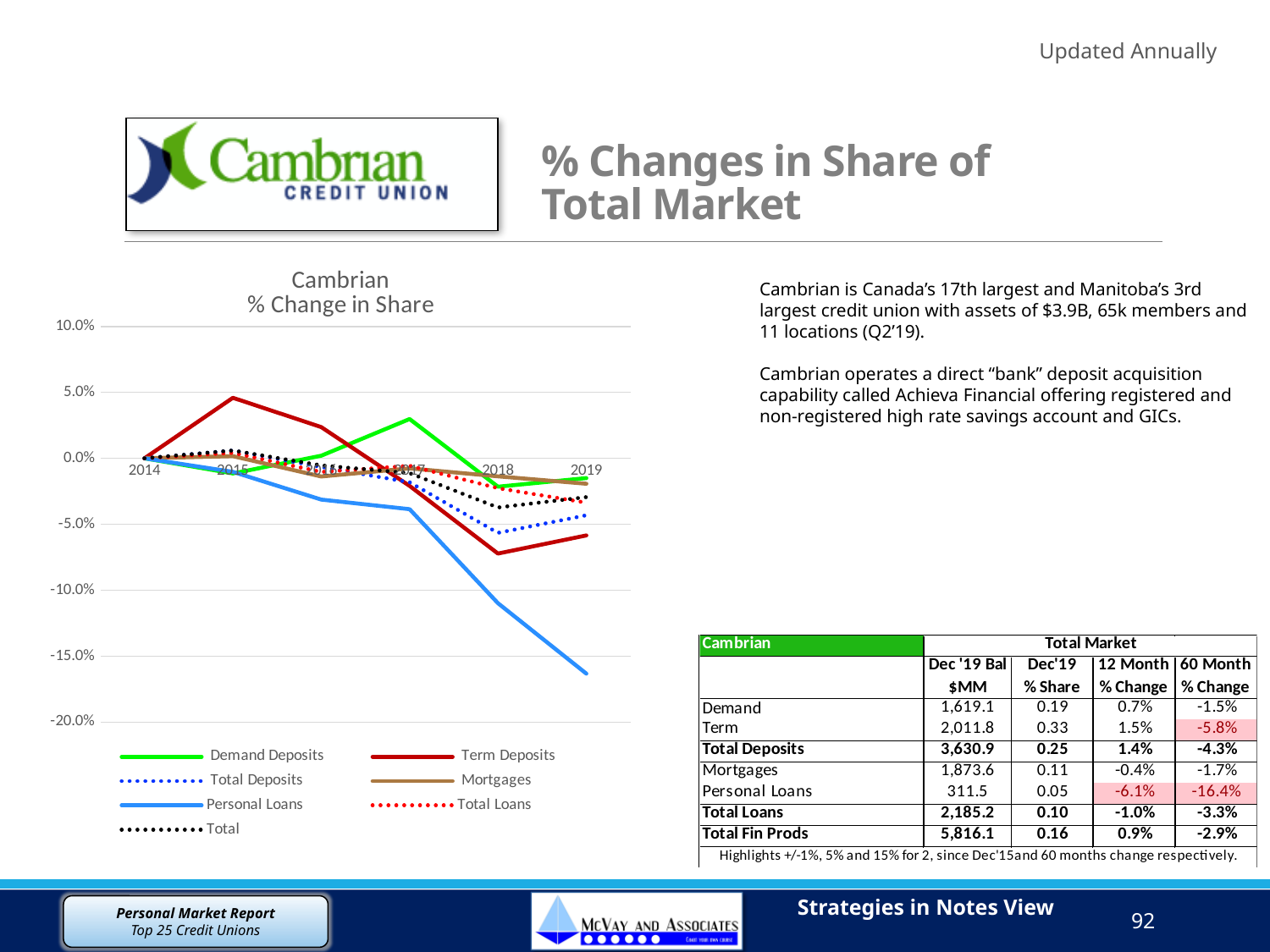
Is the value for Personal Loans in 2019 greater or less than -15.0%? less How many series does the legend of the 'Cambrian % Change in Share' chart list? 7 Is the value for Personal Loans in 2018 greater or less than -5.0%? less How many years are shown on the x axis of the 'Cambrian % Change in Share' chart? 6 What is the title of the chart on the slide? Cambrian % Change in Share Is the value for Term Deposits in 2018 greater or less than -5.0%? less Which series has the lowest value in 2019 in the 'Cambrian % Change in Share' chart? Personal Loans Which series has the highest value in 2015 in the 'Cambrian % Change in Share' chart? Term Deposits Which series has the highest value in 2017 in the 'Cambrian % Change in Share' chart? Demand Deposits What kind of chart is shown on the slide? line chart Does the Personal Loans series rise or fall from 2014 to 2019? fall